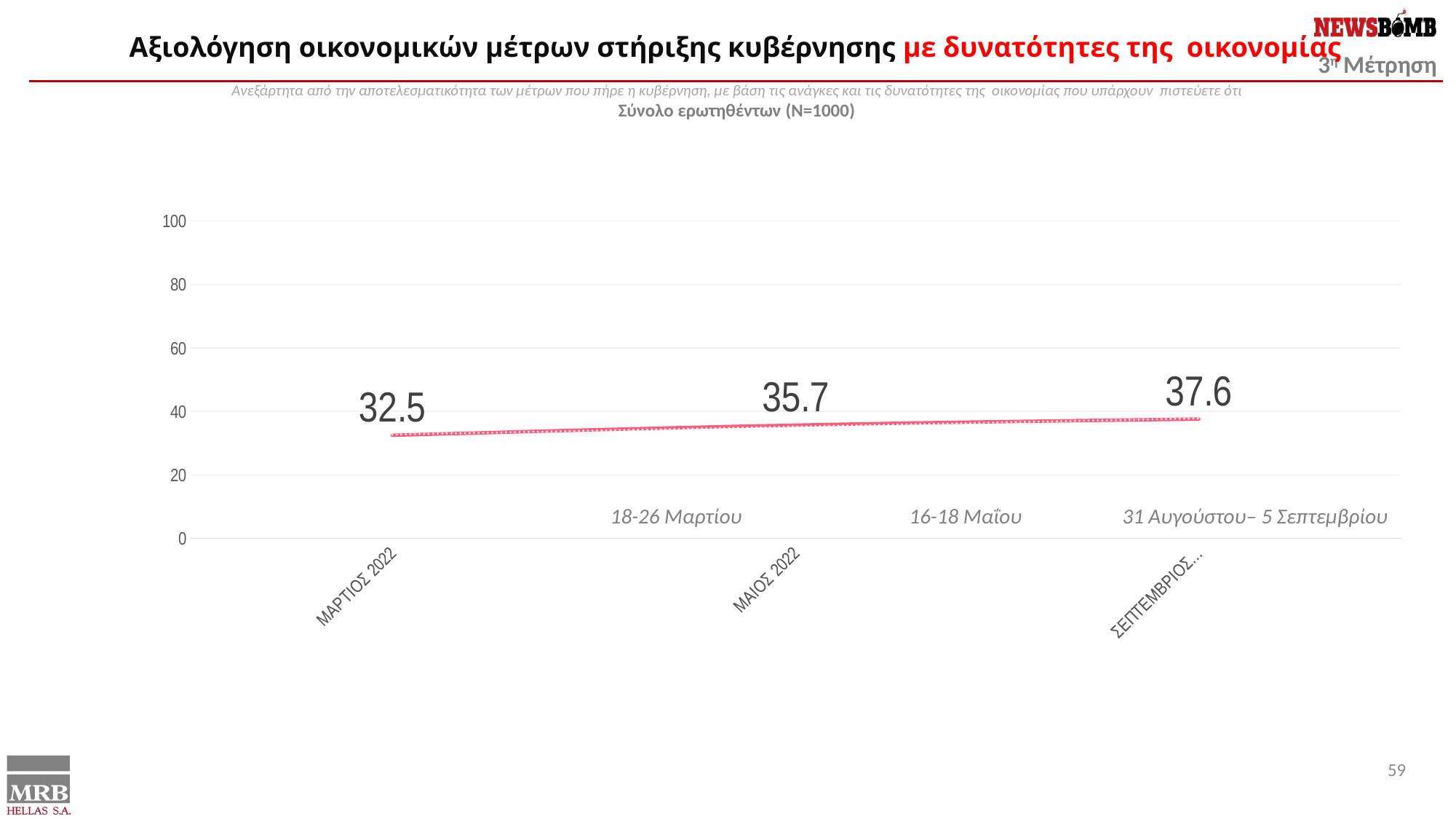
How many measurement points are plotted on the chart? 3 What is the value for ΜΑΡΤΙΟΣ 2022? 32.5 Which is larger, the value for ΜΑΙΟΣ 2022 or the value for ΜΑΡΤΙΟΣ 2022? ΜΑΙΟΣ 2022 What is the difference between the ΜΑΙΟΣ 2022 value and the ΜΑΡΤΙΟΣ 2022 value? 3.2 What is the value for the ΣΕΠΤΕΜΒΡΙΟΣ (31 Αυγούστου – 5 Σεπτεμβρίου) measurement? 37.6 Which measurement has the highest value? ΣΕΠΤΕΜΒΡΙΟΣ What is the difference between the ΣΕΠΤΕΜΒΡΙΟΣ value and the ΜΑΡΤΙΟΣ 2022 value? 5.1 Do the values rise or fall from ΜΑΡΤΙΟΣ 2022 to ΣΕΠΤΕΜΒΡΙΟΣ? rise Which measurement has the lowest value? ΜΑΡΤΙΟΣ 2022 What kind of chart is shown on the slide? line chart Is the value for ΣΕΠΤΕΜΒΡΙΟΣ greater or less than 40? less What is the value for ΜΑΙΟΣ 2022? 35.7